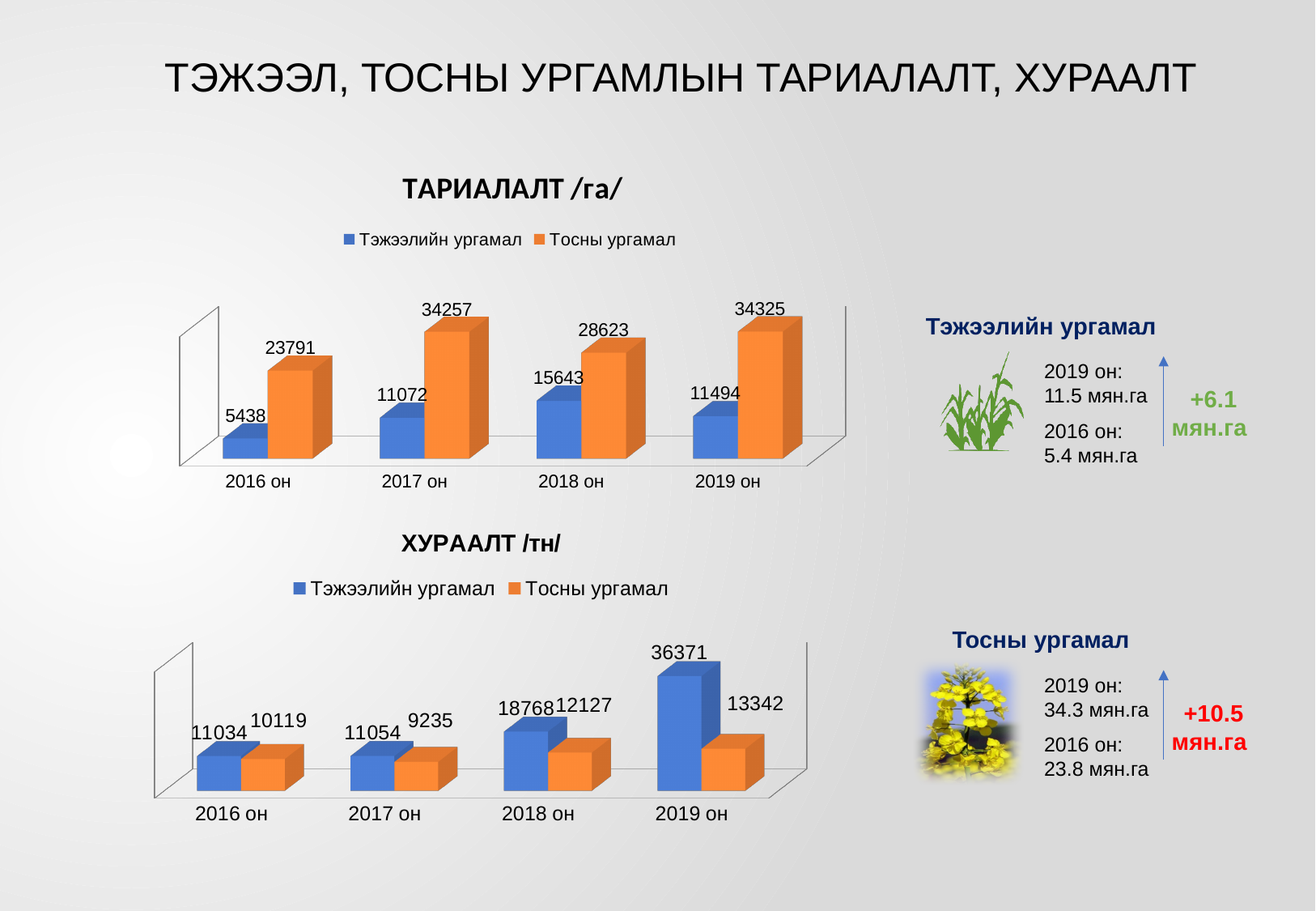
How many series does the legend of the ТАРИАЛАЛТ /га/ chart list? 2 In the ХУРААЛТ /тн/ chart, which is larger in 2018 он: Тэжээлийн ургамал or Тосны ургамал? Тэжээлийн ургамал In the ХУРААЛТ /тн/ chart, what is the value for Тосны ургамал in 2017 он? 9235 In the ХУРААЛТ /тн/ chart, does the value for Тэжээлийн ургамал rise or fall from 2016 он to 2019 он? rise In the ТАРИАЛАЛТ /га/ chart, which year has the highest value for Тэжээлийн ургамал? 2018 он In the ХУРААЛТ /тн/ chart, which year has the lowest value for Тосны ургамал? 2017 он In the ХУРААЛТ /тн/ chart, what is the value for Тэжээлийн ургамал in 2019 он? 36371 How many years are shown on the x axis of the ХУРААЛТ /тн/ chart? 4 In the ТАРИАЛАЛТ /га/ chart, what is the difference between Тосны ургамал and Тэжээлийн ургамал in 2019 он? 22831 In the ТАРИАЛАЛТ /га/ chart, what is the value for Тэжээлийн ургамал in 2018 он? 15643 In the ТАРИАЛАЛТ /га/ chart, which year has the lowest value for Тэжээлийн ургамал? 2016 он In the ТАРИАЛАЛТ /га/ chart, what is the value for Тосны ургамал in 2017 он? 34257